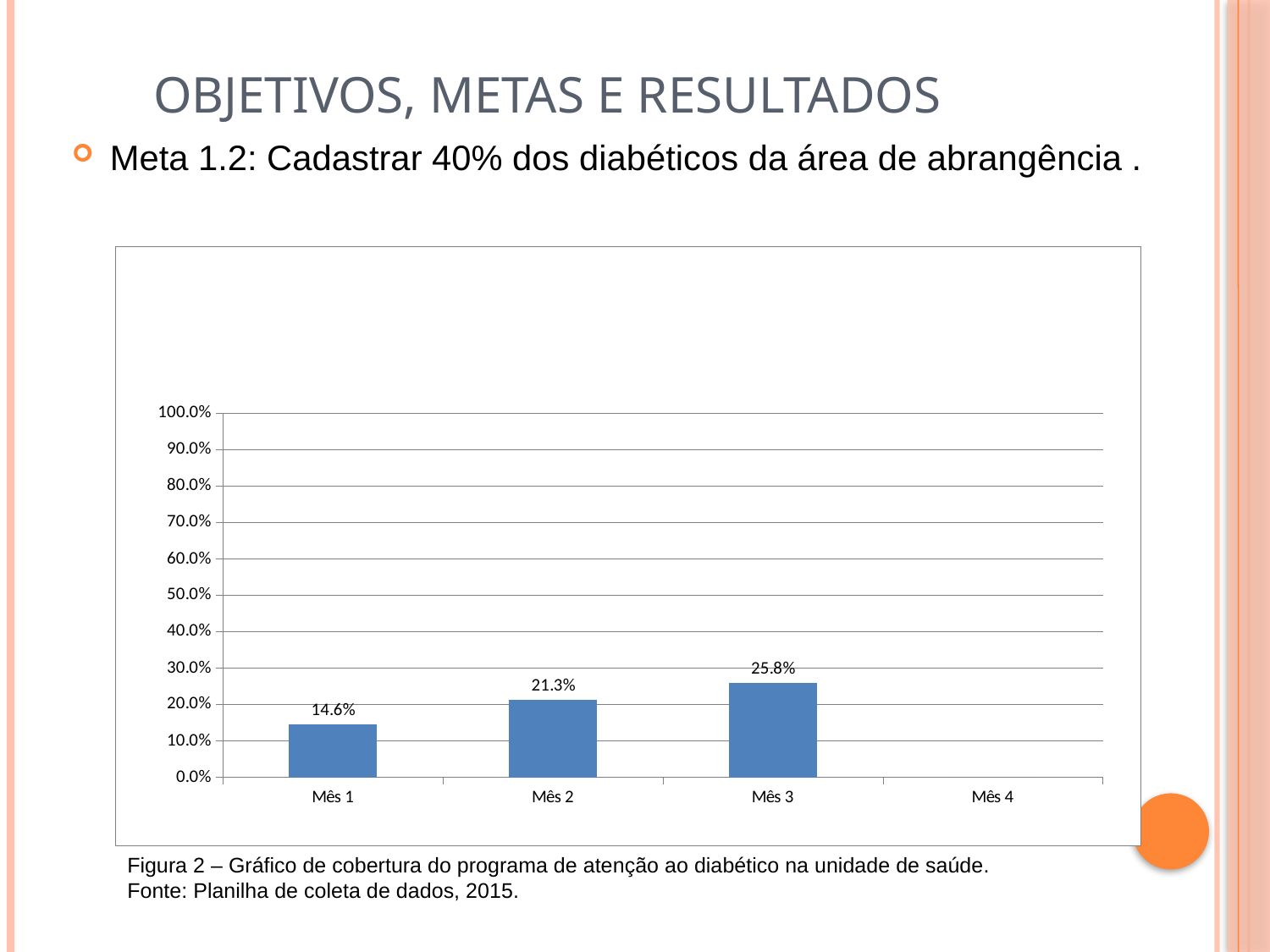
What kind of chart is shown on the slide? bar chart Which is larger, the value for Mês 2 or the value for Mês 3? Mês 3 What is the value for Mês 3? 25.8% What is the difference between the values for Mês 2 and Mês 1? 6.7% Is the value for Mês 3 greater or less than 30.0%? less What is the value for Mês 2? 21.3% What is the value for Mês 1? 14.6% Do the values rise or fall from Mês 1 to Mês 3? rise How many categories are shown on the x axis? 4 Which month has the highest value? Mês 3 Which month with a plotted bar has the lowest value? Mês 1 What is the difference between the values for Mês 3 and Mês 1? 11.2%